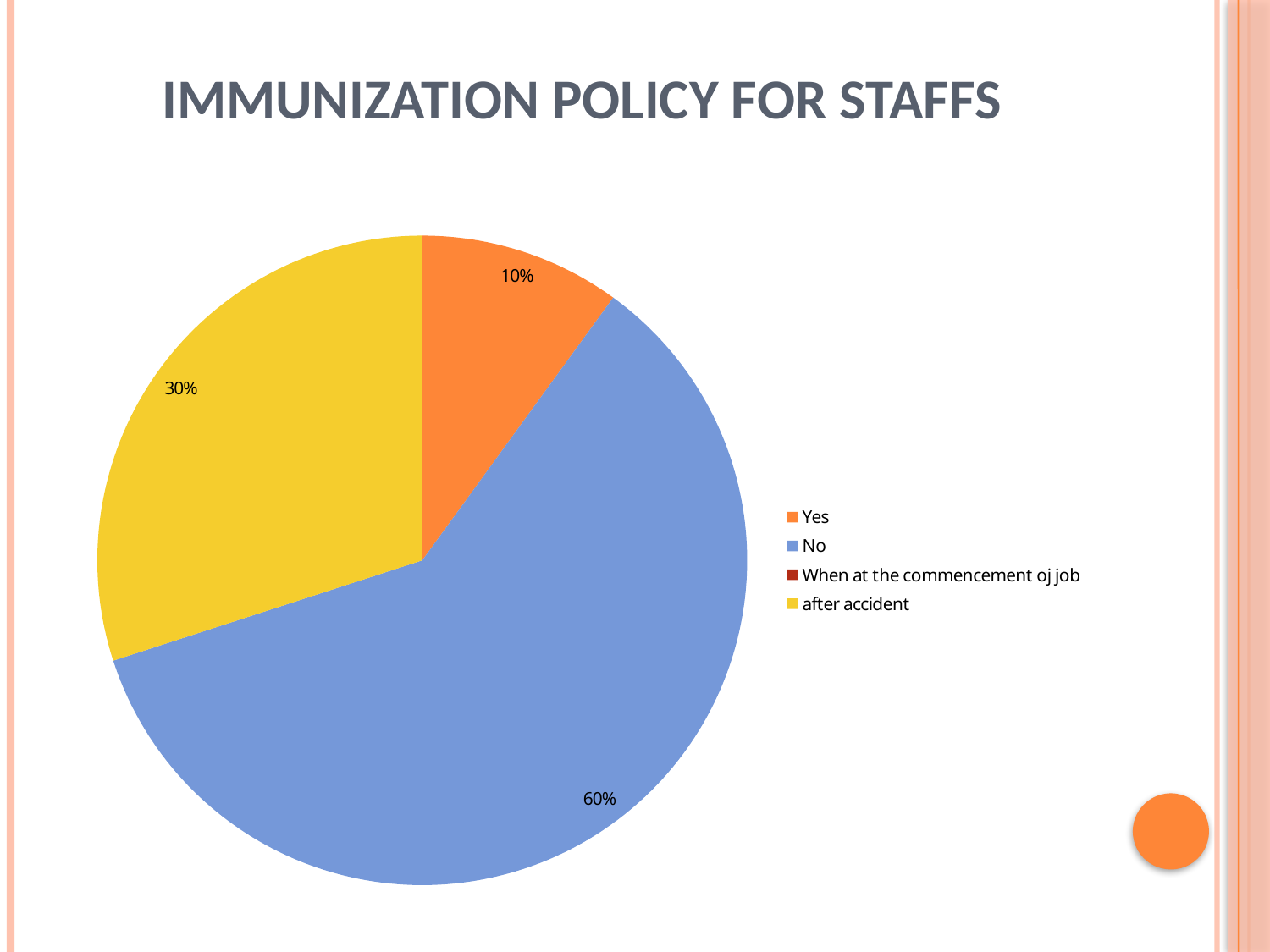
What is the difference in percentage points between the "No" slice and the "after accident" slice? 30% Which is larger, the "Yes" slice or the "after accident" slice? after accident Which category has the largest slice of the pie? No What share of the pie does the "No" slice represent? 60% What share of the pie does the "after accident" slice represent? 30% Which of the visible slices is the smallest? Yes How many entries does the legend list? 4 What share of the pie does the "Yes" slice represent? 10% What colour is the "No" slice of the pie? blue What is the title of the slide containing the chart? IMMUNIZATION POLICY FOR STAFFS What is the difference in percentage points between the "after accident" slice and the "Yes" slice? 20% What kind of chart is shown on the slide? pie chart